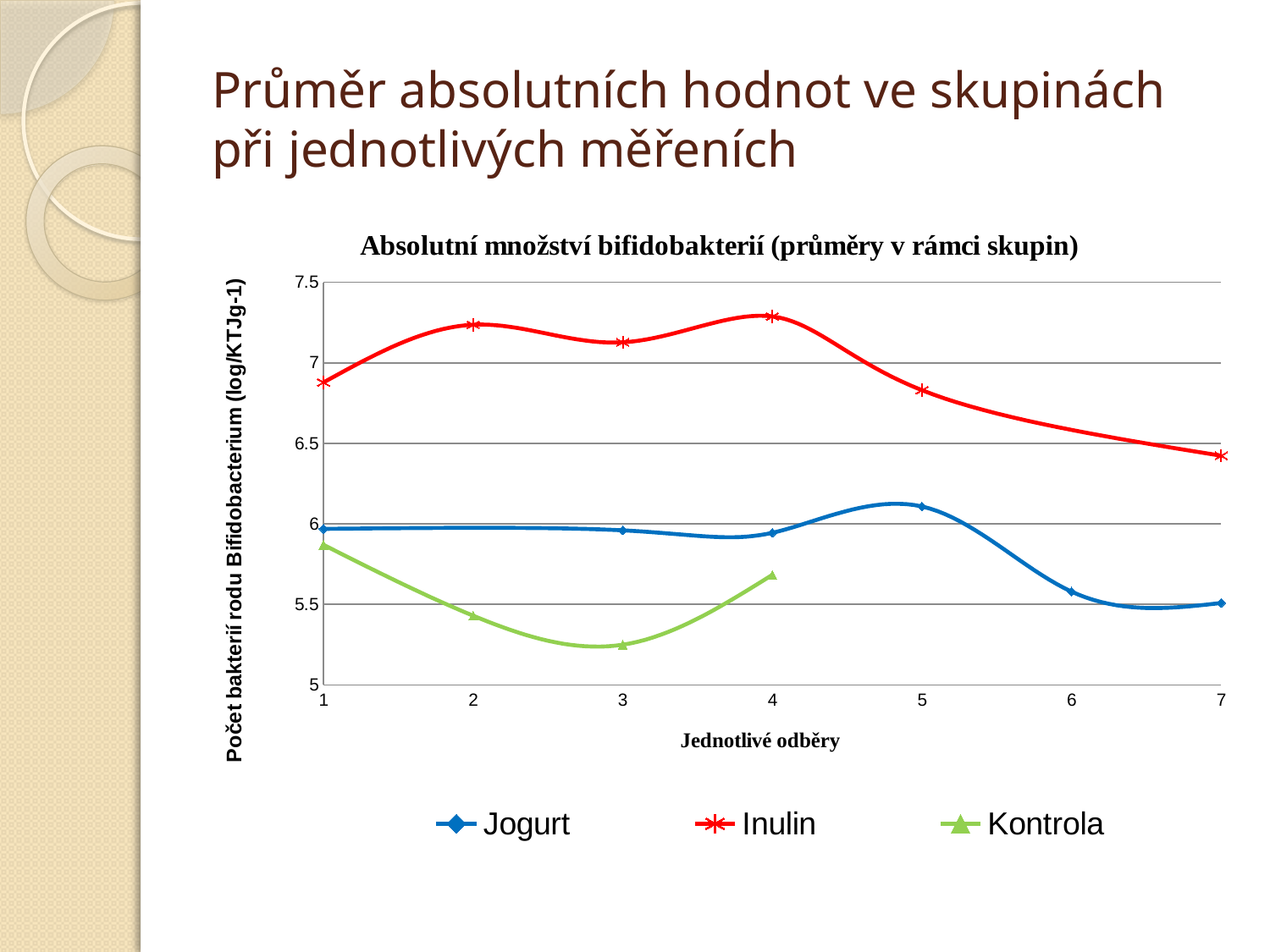
How many data points does the Kontrola series have? 4 Do the Inulin values rise or fall from sampling point 4 to sampling point 7? fall Is the value for Inulin at sampling point 4 greater or less than 7? greater What is the title of the chart? Absolutní množství bifidobakterií (průměry v rámci skupin) At sampling point 4, which series has the larger value, Inulin or Jogurt? Inulin Which series has the lowest value at sampling point 3? Kontrola How many series does the legend list? 3 How many sampling points (odběry) are shown on the x axis? 7 Is the value for Inulin at sampling point 7 greater or less than 6.5? less Is the value for Jogurt at sampling point 5 greater or less than 6? greater What kind of chart is shown on the slide? line chart